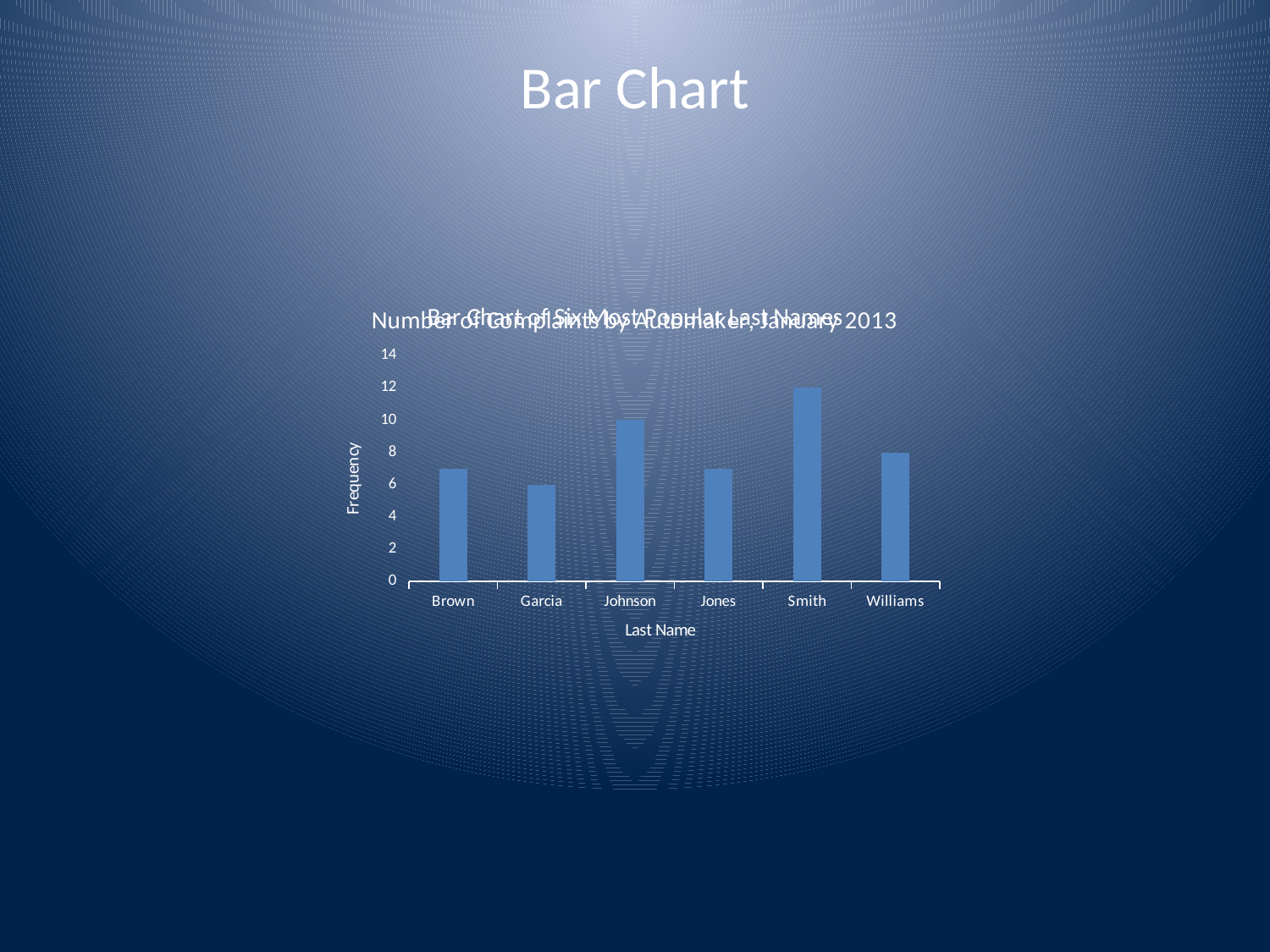
What is the frequency for Johnson? 10 Is the value for Brown greater or less than 6? greater What is the frequency for Williams? 8 Which last name has the highest frequency in the chart? Smith Is the value for Jones greater or less than 8? less Which has a higher frequency, Johnson or Williams? Johnson What is the label on the y axis of the chart? Frequency What is the frequency for Garcia? 6 Which last name has the lowest frequency in the chart? Garcia How many last names (categories) are shown on the x axis of the chart? 6 What type of chart is shown on the slide? Bar chart What is the frequency for Smith? 12